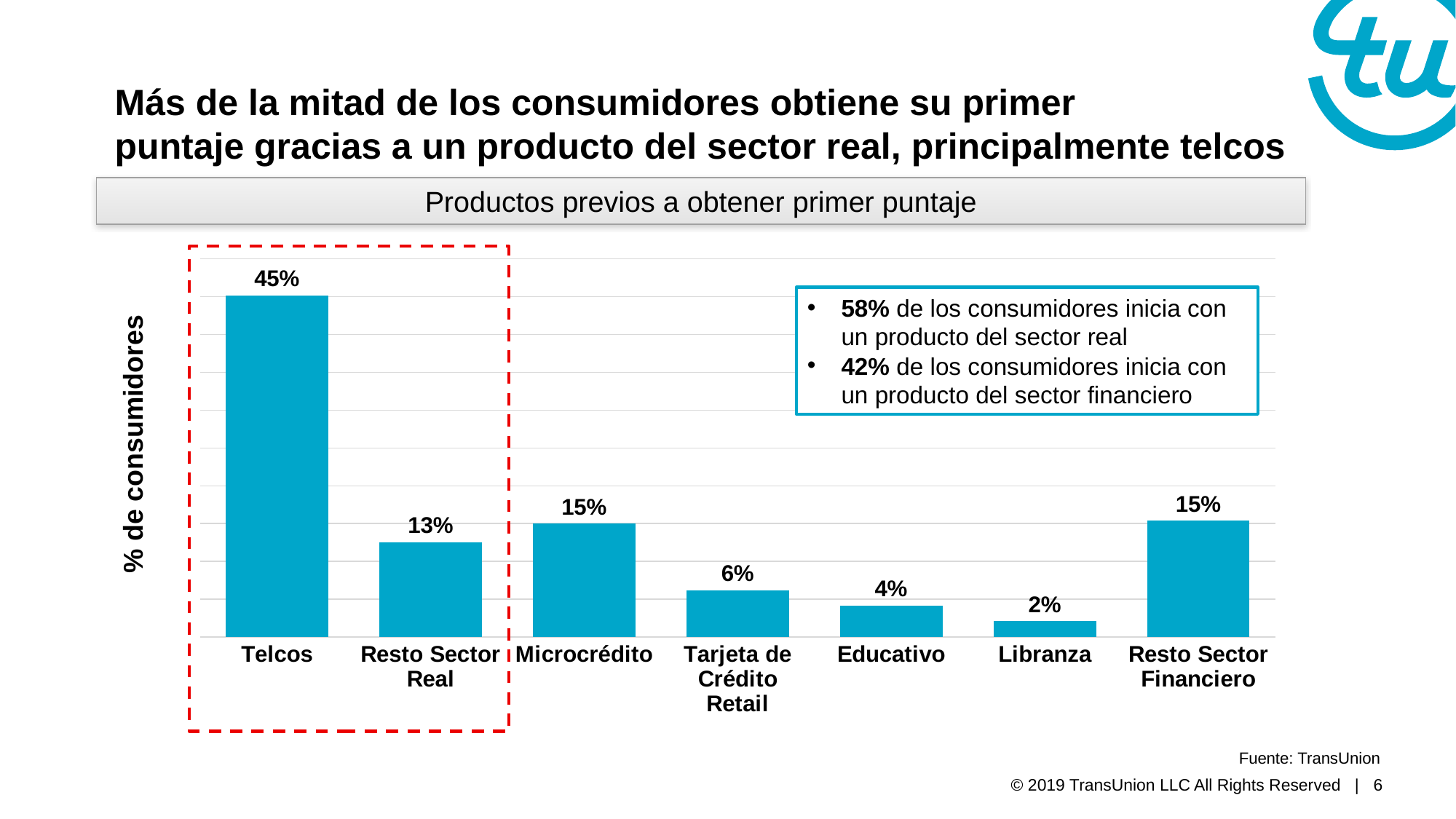
Which category has the lowest value? Libranza What is the title shown above the chart? Productos previos a obtener primer puntaje What is the value for Resto Sector Real? 13% Which is larger, the value for Educativo or the value for Tarjeta de Crédito Retail? Tarjeta de Crédito Retail What is the value for Tarjeta de Crédito Retail? 6% What is the value for Telcos? 45% What is the label of the y axis? % de consumidores What is the difference between the values for Telcos and Resto Sector Real? 32% What is the value for Libranza? 2% What kind of chart is shown? bar chart How many categories are shown on the x axis? 7 Which category has the highest value? Telcos